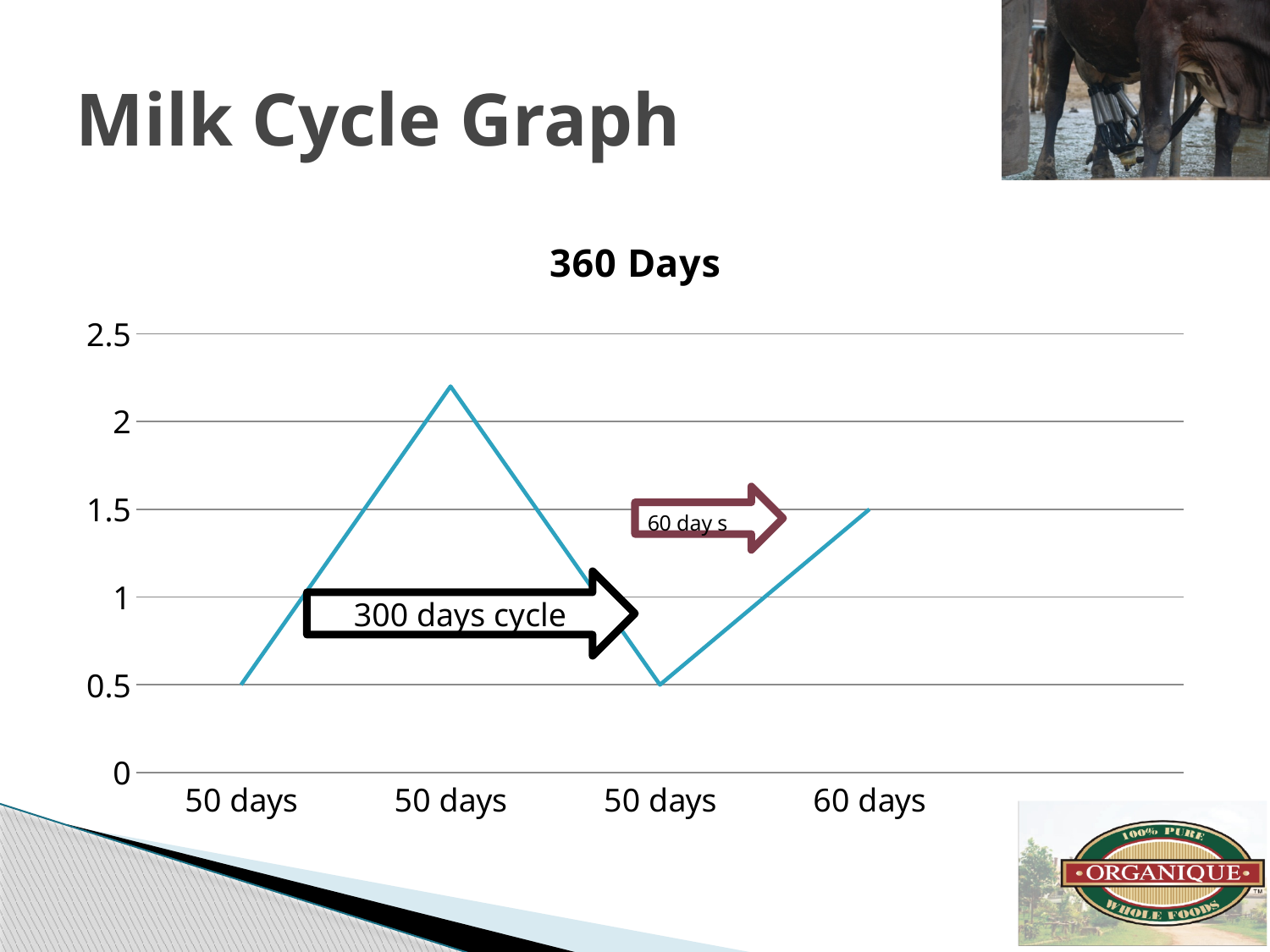
Does the line rise or fall between the third 50 days category and the 60 days category? rise What is the value at the 60 days category? 1.5 Is the value at the second 50 days category (the peak) greater or less than 2? greater What is the value at the third 50 days category (the third point from the left)? 0.5 How many data points are plotted on the line? 4 What is the value at the first 50 days category (the leftmost point)? 0.5 Which point on the line has the highest value? the second point (second 50 days) Which is larger: the value at 60 days or the value at the first 50 days category? 60 days Is the value at the second 50 days category (the peak) greater or less than 2.5? less What is the difference between the value at 60 days and the value at the first 50 days category? 1 What kind of chart is shown on the slide? line chart What is the title of the chart? 360 Days